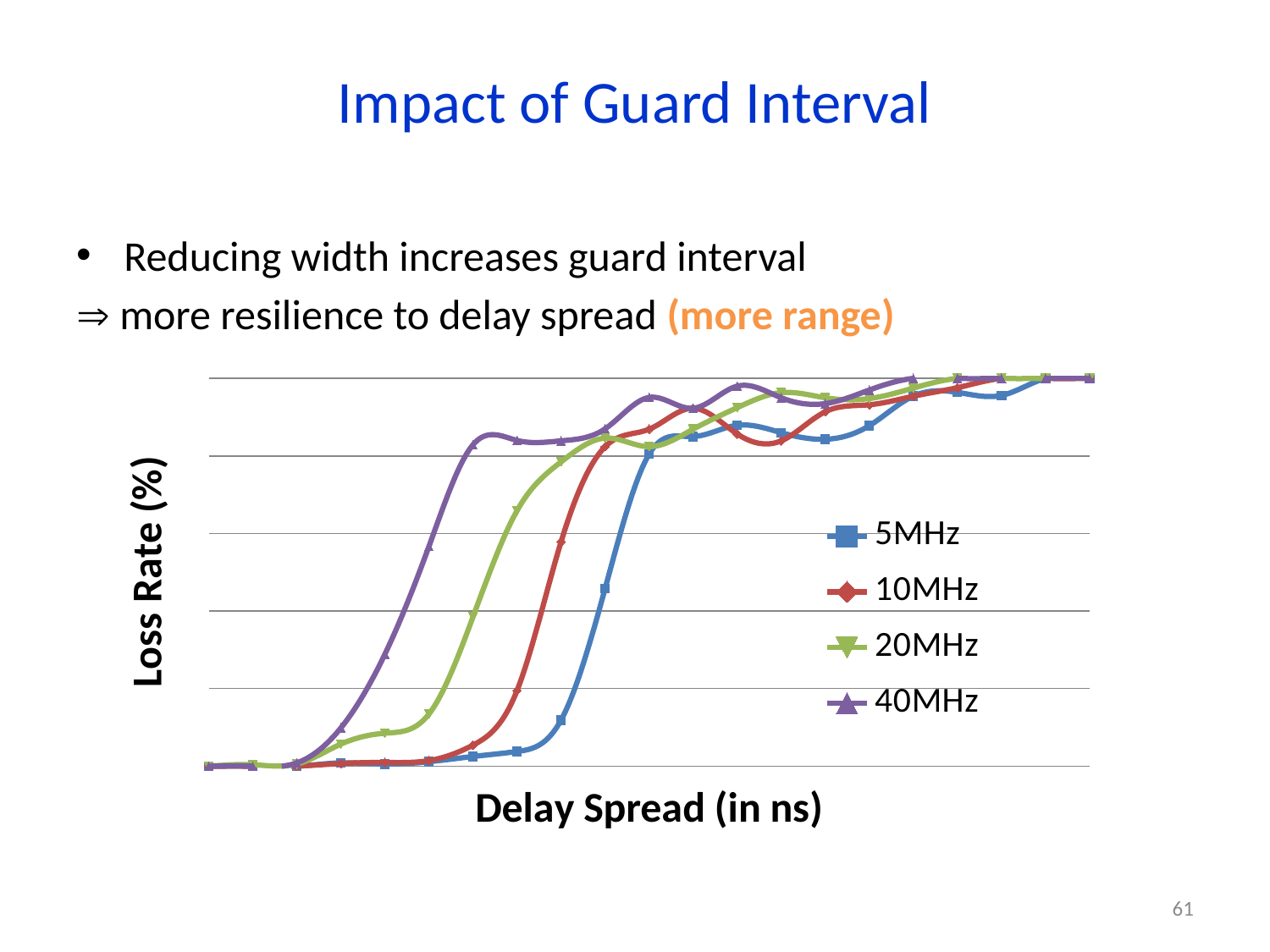
Does the loss rate for the 40MHz series rise or fall as delay spread increases? rise Does the loss rate for the 5MHz series rise or fall as delay spread increases? rise Does the loss rate for the 20MHz series rise or fall as delay spread increases? rise In the middle of the delay spread range, which series has the lower loss rate, 10MHz or 20MHz? 10MHz What kind of chart is shown on the slide? line chart Which series reaches a high loss rate at the smallest delay spread? 40MHz Which series is the last to rise to a high loss rate as delay spread increases? 5MHz How many series does the legend list? 4 What are the series listed in the legend? 5MHz, 10MHz, 20MHz, 40MHz What is the title of the x axis? Delay Spread (in ns)